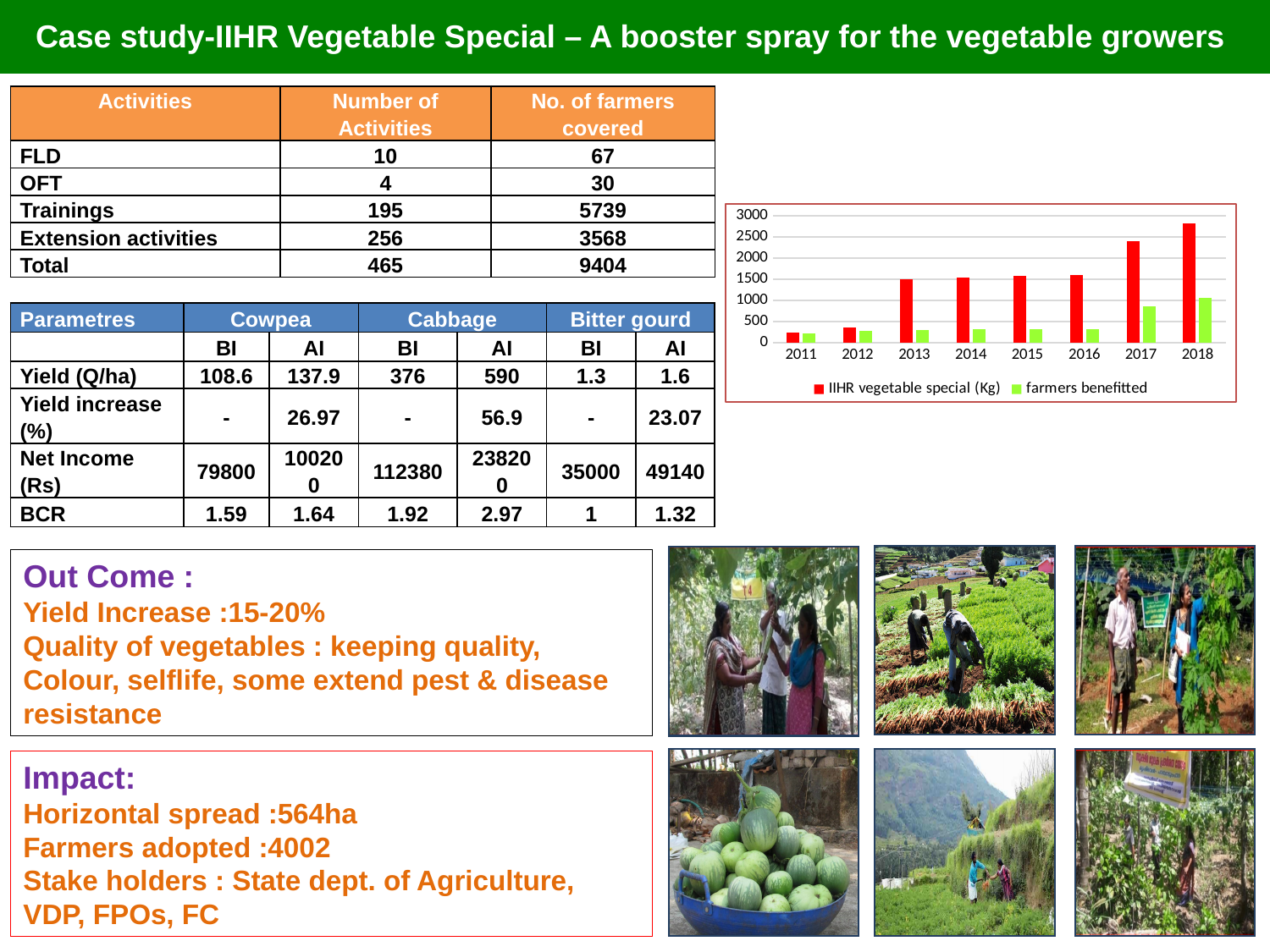
What kind of chart is shown on the slide? bar chart Is the value for IIHR vegetable special (Kg) in 2017 greater or less than 2000? greater Is the value for farmers benefitted in 2018 greater or less than 500? greater How many series does the chart legend list? 2 Which is larger in 2017: IIHR vegetable special (Kg) or farmers benefitted? IIHR vegetable special (Kg) Is the value for IIHR vegetable special (Kg) in 2011 greater or less than 500? less How many years are shown on the x axis of the chart? 8 What colour represents the farmers benefitted series in the chart? green In which year is the value for farmers benefitted highest? 2018 Does the value for IIHR vegetable special (Kg) generally rise or fall from 2011 to 2018? rise In which year is the value for IIHR vegetable special (Kg) highest? 2018 In which year is the value for IIHR vegetable special (Kg) lowest? 2011